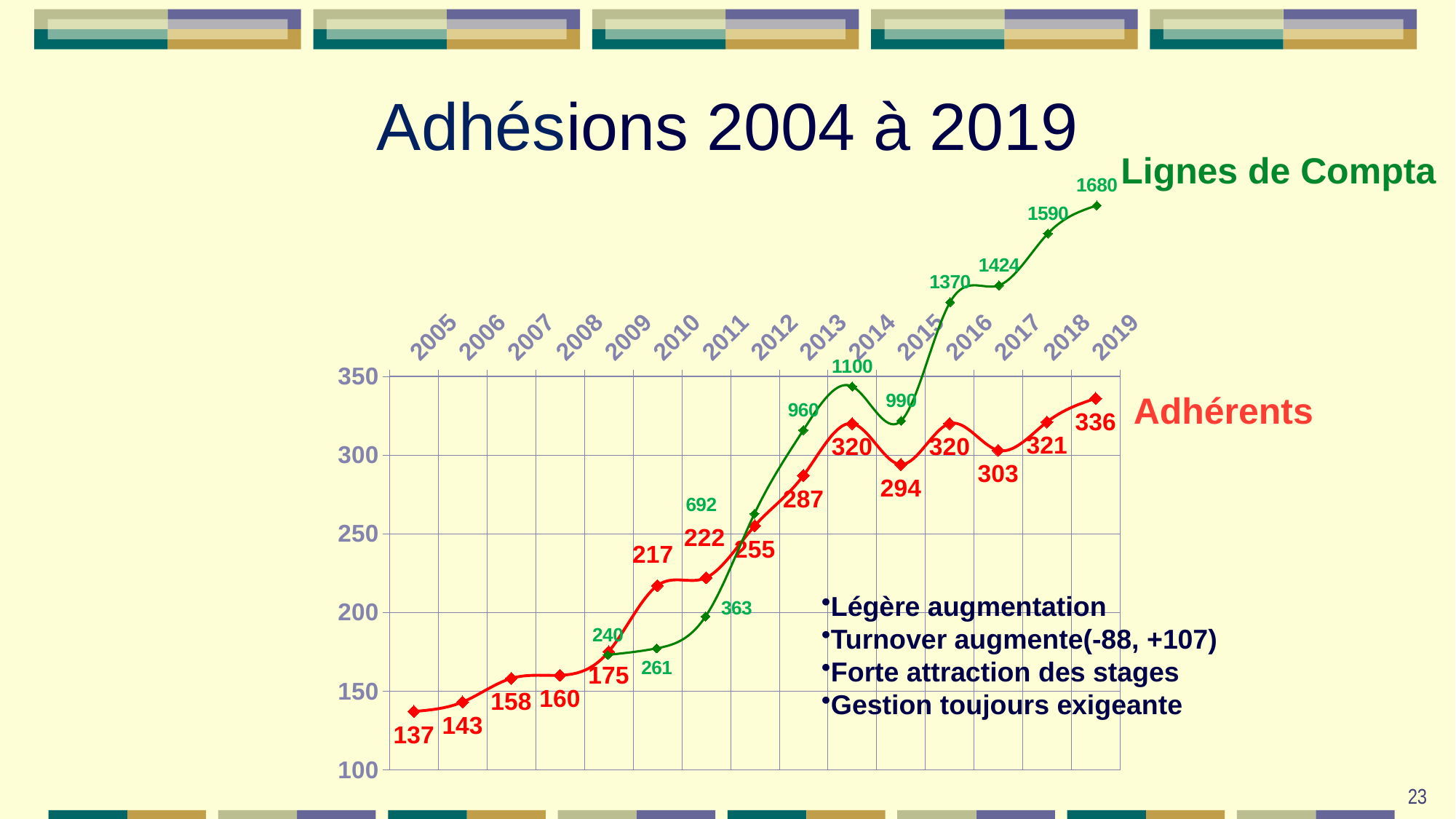
Which colour is used for the Lignes de Compta series? green How many data points does the Adhérents series have? 15 What is the title of the chart on the slide? Adhésions 2004 à 2019 What is the first (leftmost) value of the Adhérents series? 137 What kind of chart is shown on the slide? line chart How many data points does the Lignes de Compta series have? 11 What is the lowest value of the Lignes de Compta series? 240 What is the last (rightmost) value of the Lignes de Compta series? 1680 What is the difference between the last and the first Adhérents values (336 and 137)? 199 What is the highest value reached by the Adhérents series? 336 What is the last (rightmost) value of the Adhérents series? 336 Is the last Adhérents value greater or less than 300? greater